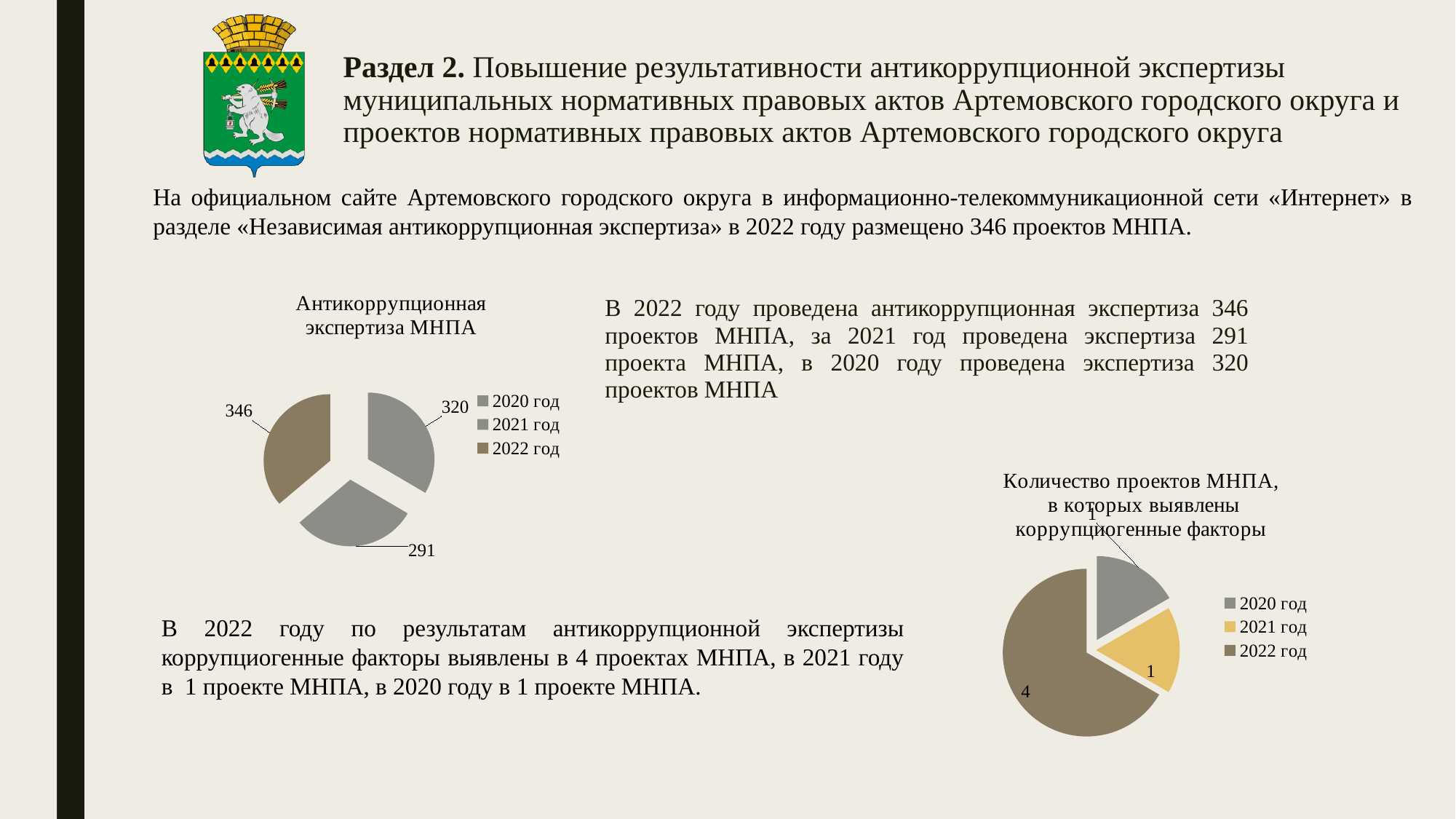
What type of chart is the one titled «Антикоррупционная экспертиза МНПА»? pie chart On the chart titled «Количество проектов МНПА, в которых выявлены коррупциогенные факторы», what is the difference between the values for 2022 год and 2020 год? 3 On the chart titled «Антикоррупционная экспертиза МНПА», what is the difference between the values for 2022 год and 2021 год? 55 On the chart titled «Количество проектов МНПА, в которых выявлены коррупциогенные факторы», which year has the largest slice? 2022 год On the chart titled «Антикоррупционная экспертиза МНПА», what is the value for 2021 год? 291 On the chart titled «Антикоррупционная экспертиза МНПА», which year has the largest slice? 2022 год On the chart titled «Количество проектов МНПА, в которых выявлены коррупциогенные факторы», what is the value for 2022 год? 4 On the chart titled «Количество проектов МНПА, в которых выявлены коррупциогенные факторы», what is the value for 2021 год? 1 On the chart titled «Антикоррупционная экспертиза МНПА», which is larger: the value for 2020 год or for 2021 год? 2020 год On the chart titled «Антикоррупционная экспертиза МНПА», which year has the smallest slice? 2021 год On the chart titled «Антикоррупционная экспертиза МНПА», what is the value for 2022 год? 346 How many entries does the legend of the chart titled «Количество проектов МНПА, в которых выявлены коррупциогенные факторы» list? 3